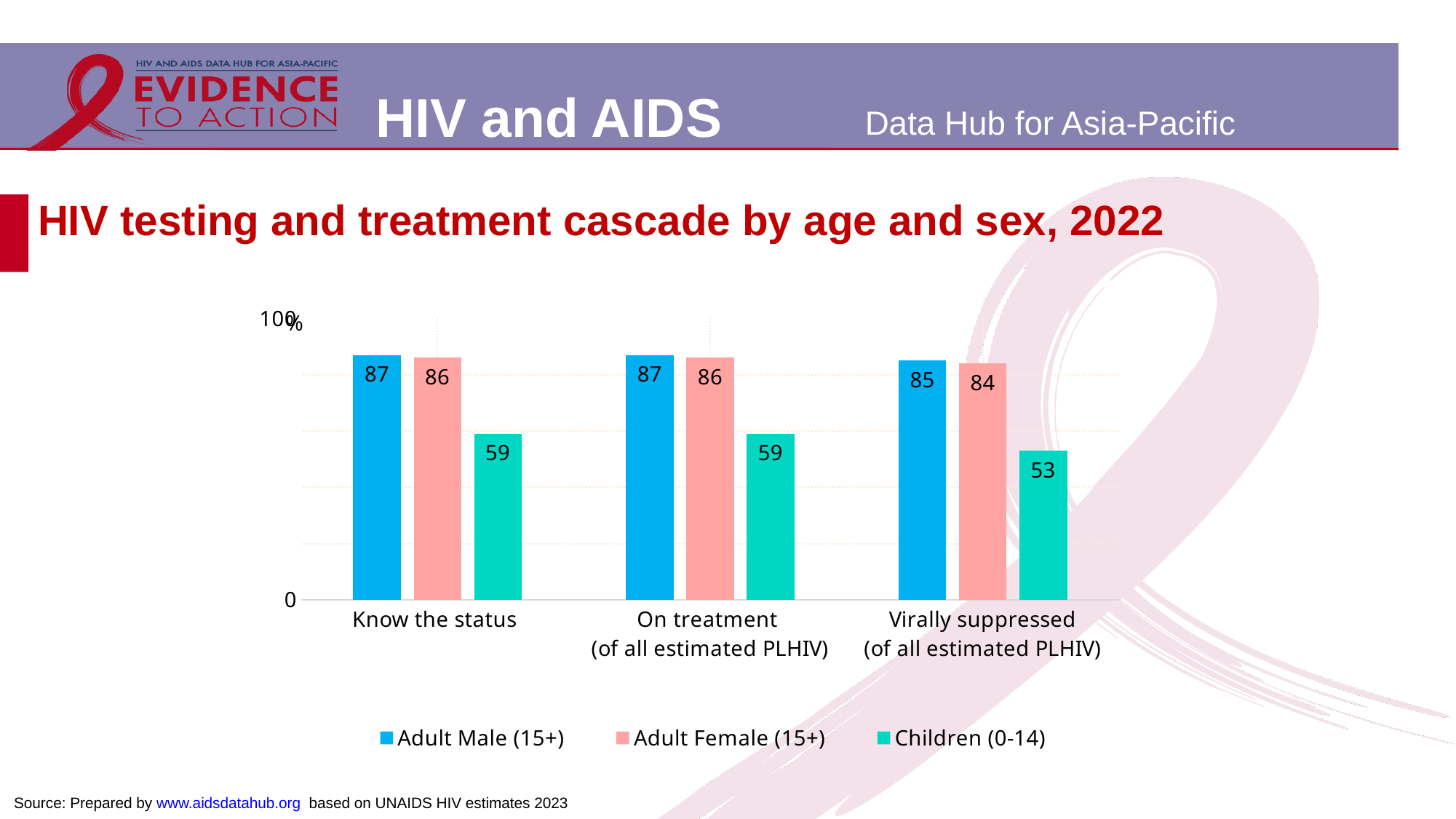
What is the value for Children (0-14) in the Virally suppressed (of all estimated PLHIV) category? 53 How many series does the legend list? 3 What is the difference between the Adult Male (15+) and Children (0-14) values in the Virally suppressed (of all estimated PLHIV) category? 32 What is the value for Adult Female (15+) in the On treatment (of all estimated PLHIV) category? 86 How many categories are shown on the x axis? 3 What colour are the bars for Children (0-14)? Teal/green What is the title of the chart? HIV testing and treatment cascade by age and sex, 2022 Which series has the lowest value in the Know the status category? Children (0-14) Do the Adult Female (15+) values rise or fall from Know the status to Virally suppressed (of all estimated PLHIV)? Fall What is the value for Adult Male (15+) in the Know the status category? 87 Which is larger: the Children (0-14) value for Know the status or for Virally suppressed (of all estimated PLHIV)? Know the status What kind of chart is shown on the slide? Bar chart